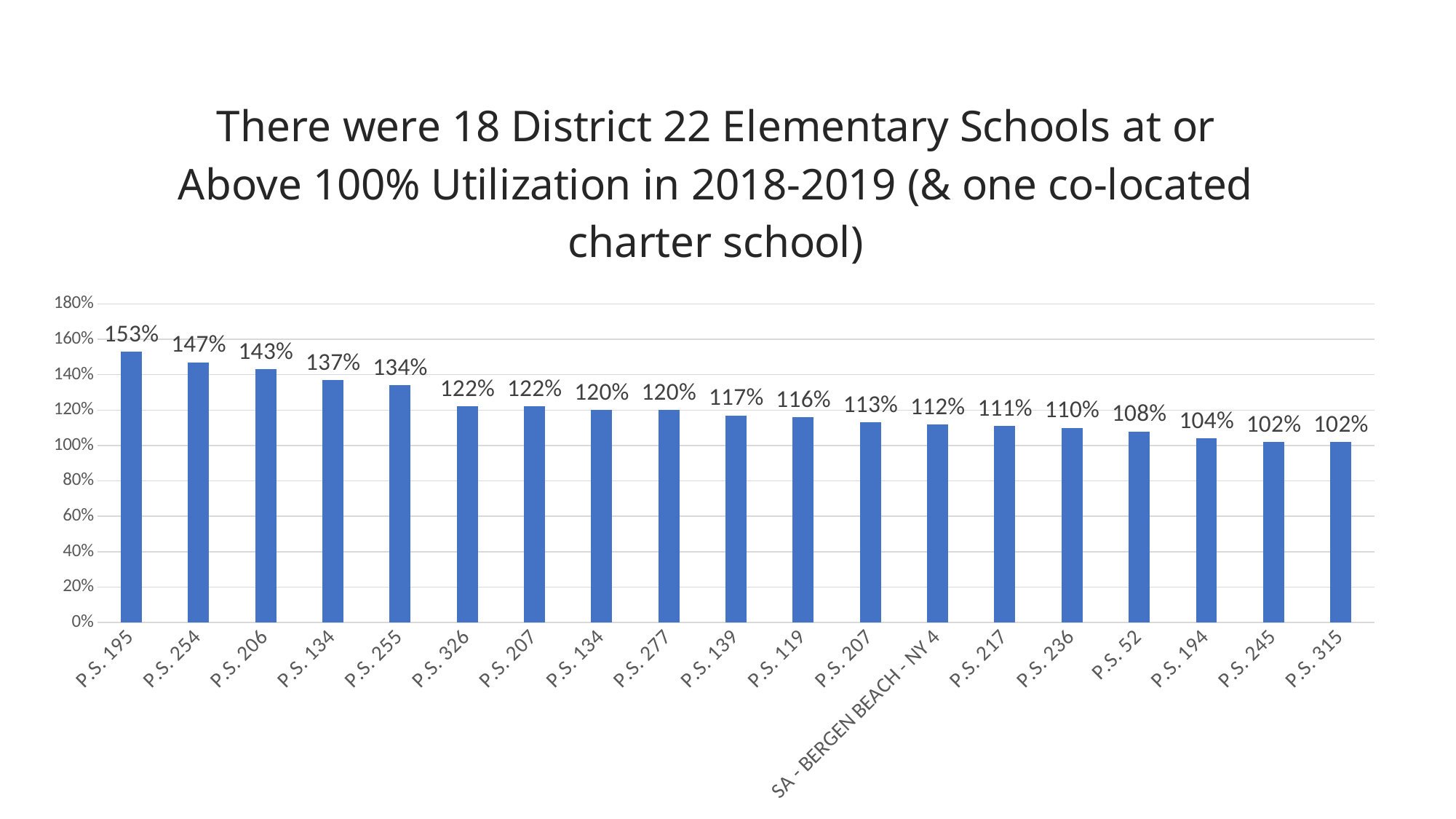
What is the lowest utilization value shown on the chart? 102% What is the utilization value for SA - BERGEN BEACH - NY 4? 112% What is the utilization value for P.S. 236? 110% What is the utilization value for P.S. 326? 122% What is the highest value labelled on the vertical axis? 180% Do the values generally rise or fall from left to right along the x axis? fall How many schools are shown on the chart? 19 What is the difference between the utilization of P.S. 254 and P.S. 206? 4% What is the utilization value for P.S. 195? 153% Which has a higher utilization, P.S. 255 or P.S. 277? P.S. 255 Which school has the highest utilization? P.S. 195 What type of chart is shown on the slide? bar chart